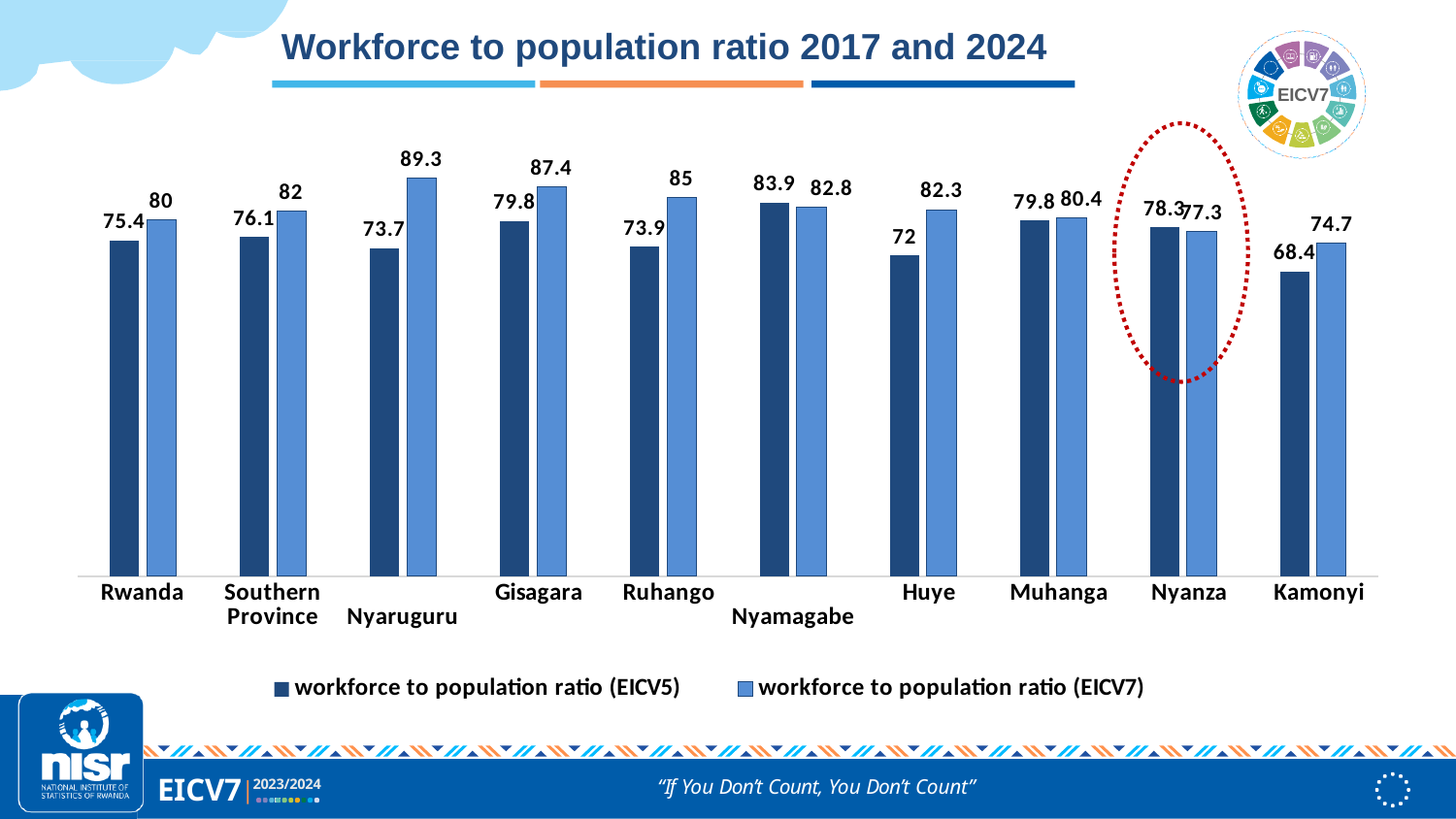
What is the workforce to population ratio (EICV7) for Kamonyi? 74.7 Which category has the lowest workforce to population ratio (EICV5)? Kamonyi How many series does the legend list? 2 Which category has the highest workforce to population ratio (EICV7)? Nyaruguru What is the difference between the EICV7 and EICV5 workforce to population ratio for Nyaruguru? 15.6 What is the workforce to population ratio (EICV7) for Nyaruguru? 89.3 What kind of chart is shown on the slide? Bar chart How many categories are shown on the x axis? 10 Which is larger for Nyanza: the EICV5 ratio or the EICV7 ratio? EICV5 ratio (78.3) Which category is highlighted with a red dotted circle? Nyanza What is the title of the chart? Workforce to population ratio 2017 and 2024 What is the workforce to population ratio (EICV5) for Huye? 72